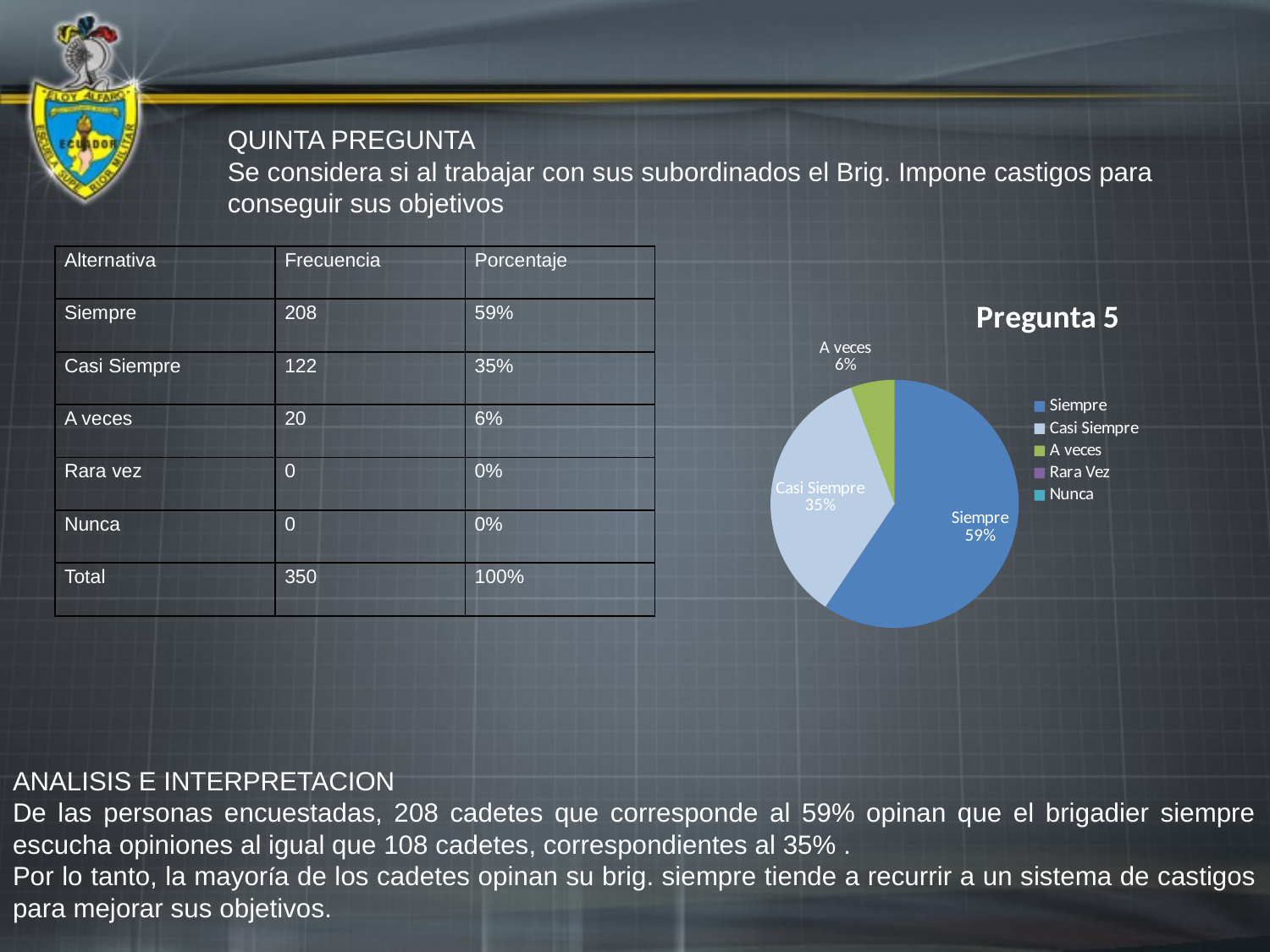
What percentage does the Siempre slice show in the pie chart? 59% What percentage does the A veces slice show in the pie chart? 6% Which slice is larger in the pie chart, Casi Siempre or A veces? Casi Siempre What is the title of the chart? Pregunta 5 How many entries does the legend of the pie chart list? 5 What percentage does the Casi Siempre slice show in the pie chart? 35% What is the difference in percentage points between the Siempre and Casi Siempre slices? 24 What colour is the Siempre slice in the pie chart? blue What is the combined share of the Siempre and Casi Siempre slices? 94% Which of the labelled slices in the pie chart is the smallest? A veces Which category has the largest slice in the pie chart? Siempre What kind of chart is shown on the slide? pie chart